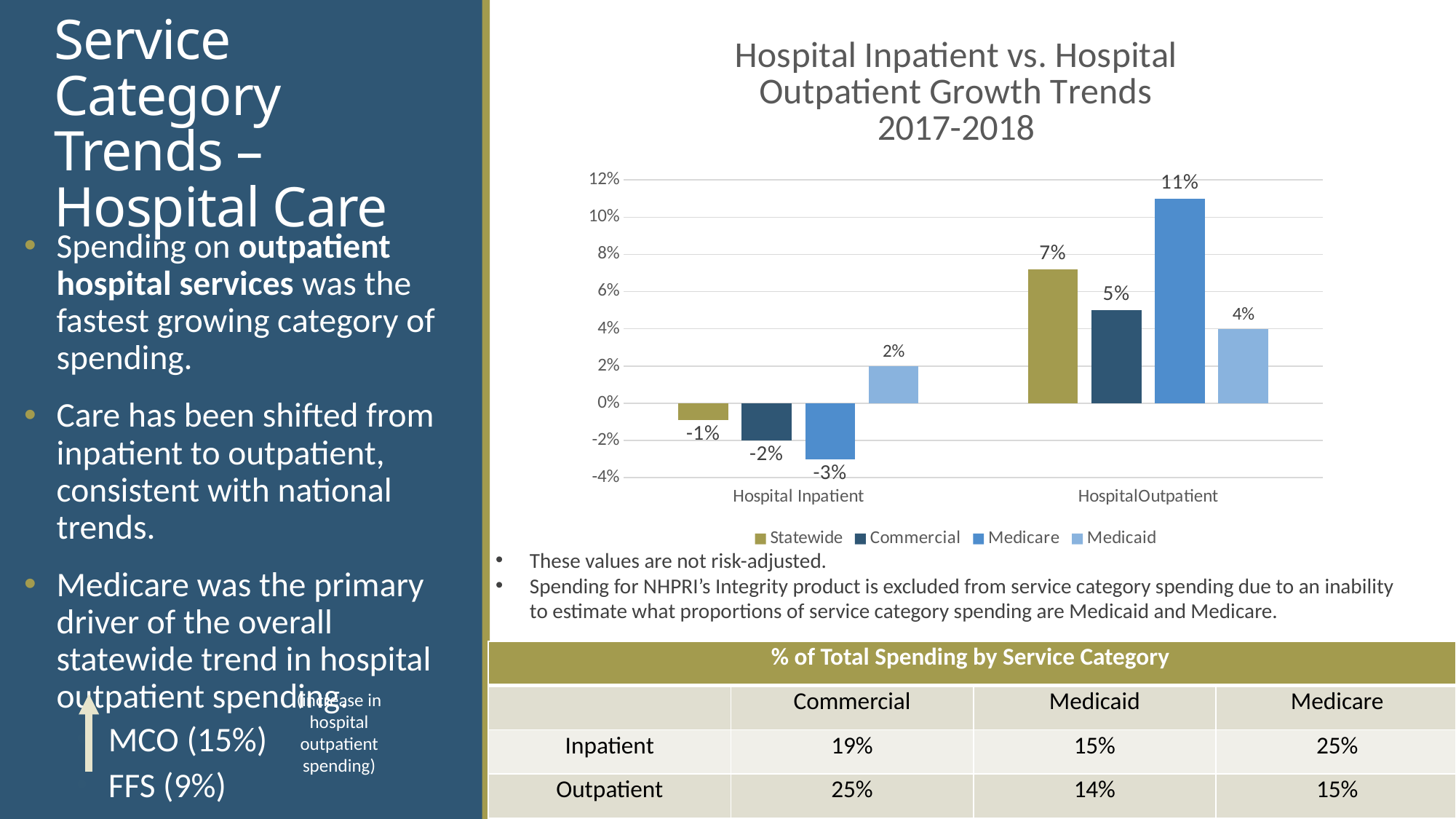
How many series does the legend list? 4 What is the Medicaid growth value for Hospital Inpatient? 2% Which is larger, the Statewide value for Hospital Outpatient or the Commercial value for Hospital Outpatient? Statewide What is the Commercial growth value for Hospital Outpatient? 5% What is the difference between the Medicare values for Hospital Outpatient and Hospital Inpatient? 14 percentage points What is the Statewide growth value for Hospital Inpatient? -1% Which series has the lowest growth value for Hospital Inpatient? Medicare How many categories are shown on the x axis? 2 What kind of chart is shown on the slide? Bar chart What is the title of the chart? Hospital Inpatient vs. Hospital Outpatient Growth Trends 2017-2018 What is the Medicare growth value for Hospital Outpatient? 11% Which series has the highest growth value for Hospital Outpatient? Medicare